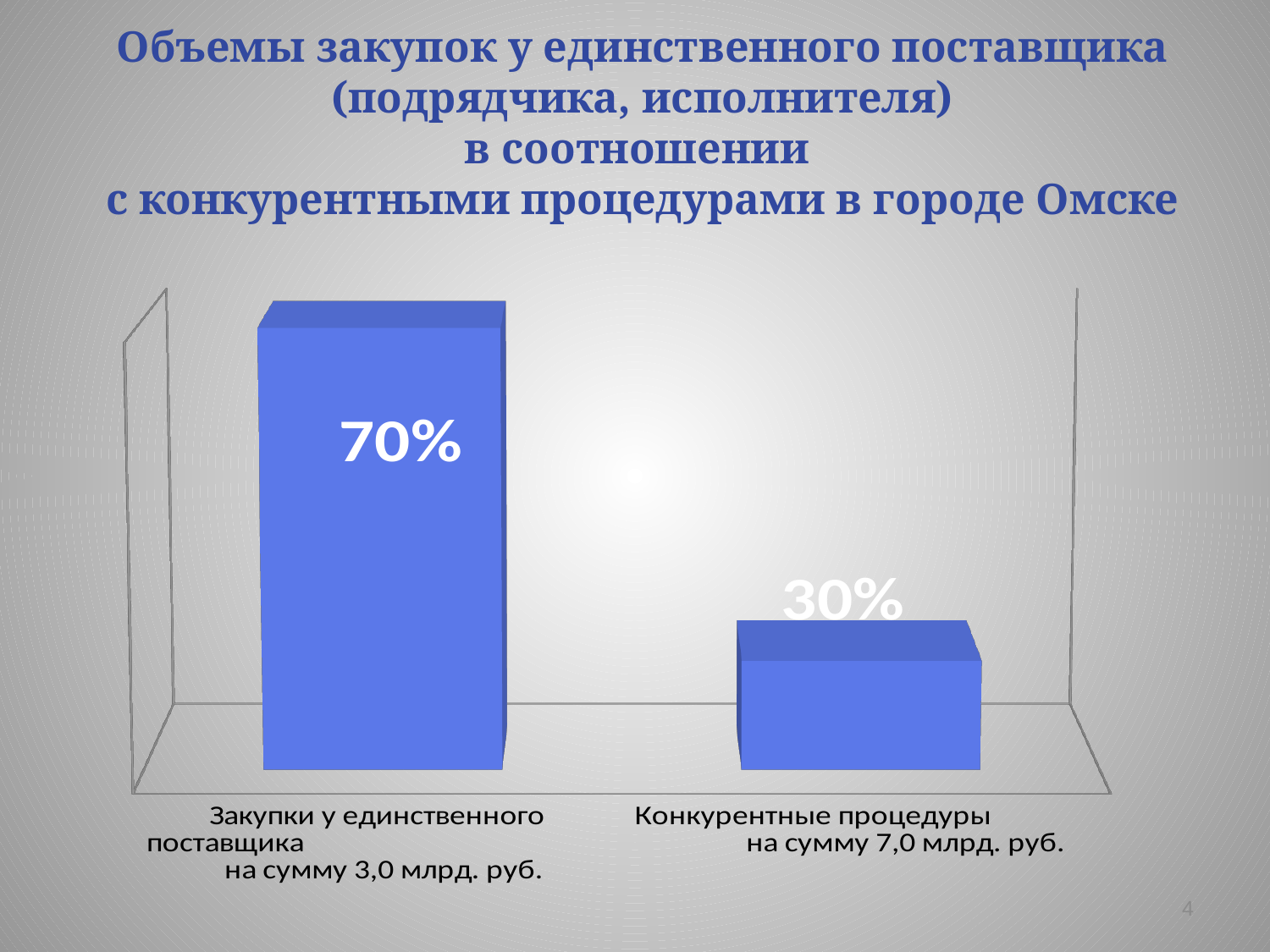
Do the values fall or rise from the left bar to the right bar? Fall How many bars are plotted in the chart? 2 What amount in rubles is given in the label for "Конкурентные процедуры"? 7,0 млрд. руб. What is the total of the two values shown in the chart? 100% Which category has the highest value? Закупки у единственного поставщика What value is shown for the bar labelled "Закупки у единственного поставщика"? 70% What value is shown for the bar labelled "Конкурентные процедуры"? 30% What kind of chart is shown on the slide? Bar chart Which category has the lowest value? Конкурентные процедуры What amount in rubles is given in the label for "Закупки у единственного поставщика"? 3,0 млрд. руб. Which is larger: the value for "Закупки у единственного поставщика" or for "Конкурентные процедуры"? Закупки у единственного поставщика What is the difference between the values for "Закупки у единственного поставщика" and "Конкурентные процедуры"? 40%